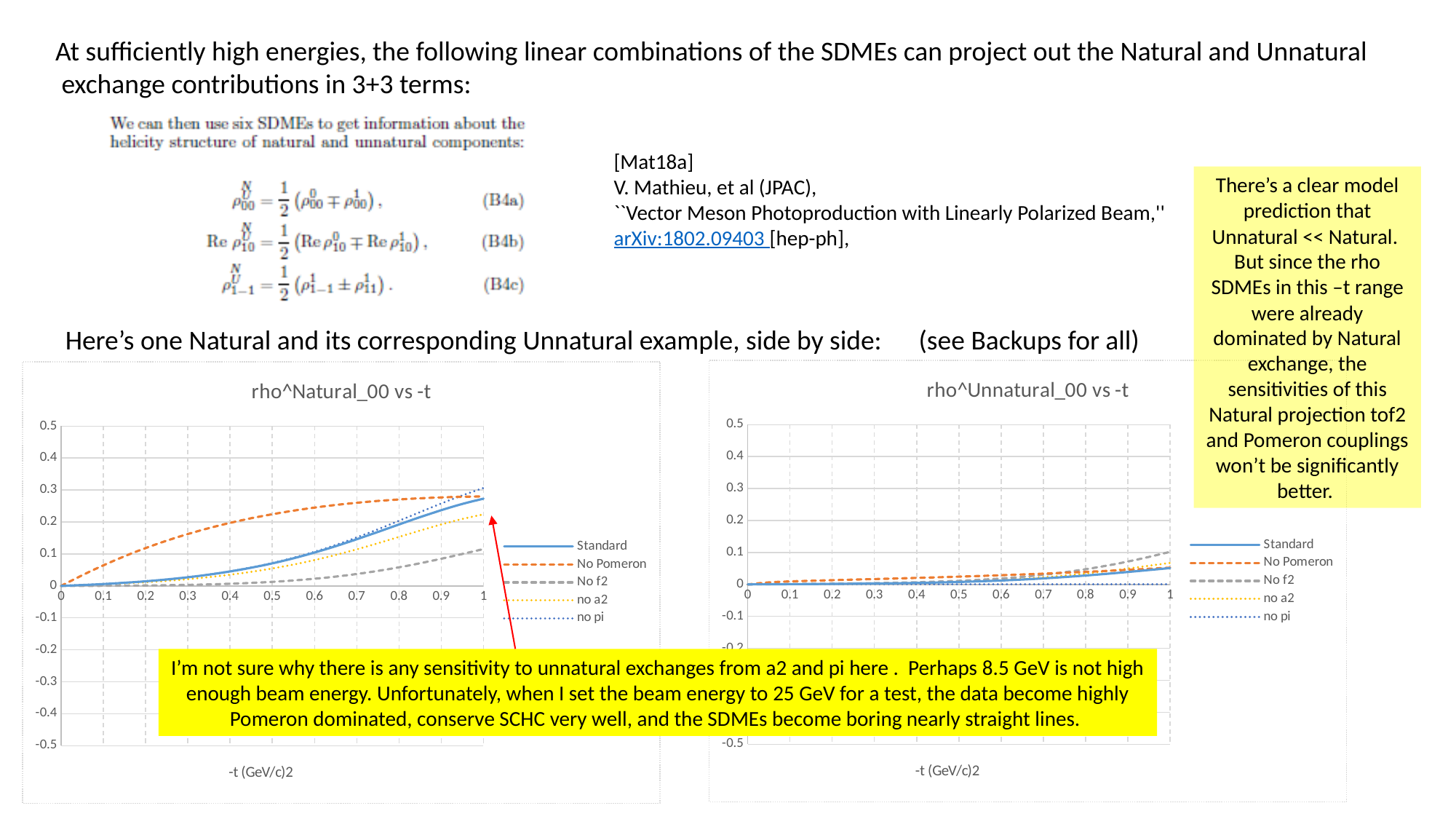
In the 'rho^Natural_00 vs -t' chart, which series is highest at -t = 0.5? No Pomeron In the 'rho^Unnatural_00 vs -t' chart, is the Standard value at -t = 1 greater or less than 0.1? less In the 'rho^Natural_00 vs -t' chart, does the Standard series rise or fall as -t increases from 0 to 1? rise How many series does the legend of the 'rho^Unnatural_00 vs -t' chart list? 5 In the 'rho^Unnatural_00 vs -t' chart, at -t = 1, which is larger: No f2 or no pi? No f2 In the 'rho^Natural_00 vs -t' chart, is the No Pomeron value at -t = 0.5 greater or less than 0.2? greater In the 'rho^Natural_00 vs -t' chart, which series is lowest at -t = 0.5? No f2 What is the x-axis label on the 'rho^Unnatural_00 vs -t' chart? -t (GeV/c)2 In the 'rho^Natural_00 vs -t' chart, is the Standard value at -t = 0.5 greater or less than 0.1? less What is the title of the left chart? rho^Natural_00 vs -t In the 'rho^Natural_00 vs -t' chart, at -t = 0.3, which is larger: No Pomeron or Standard? No Pomeron What kind of chart is the 'rho^Natural_00 vs -t' chart? line chart